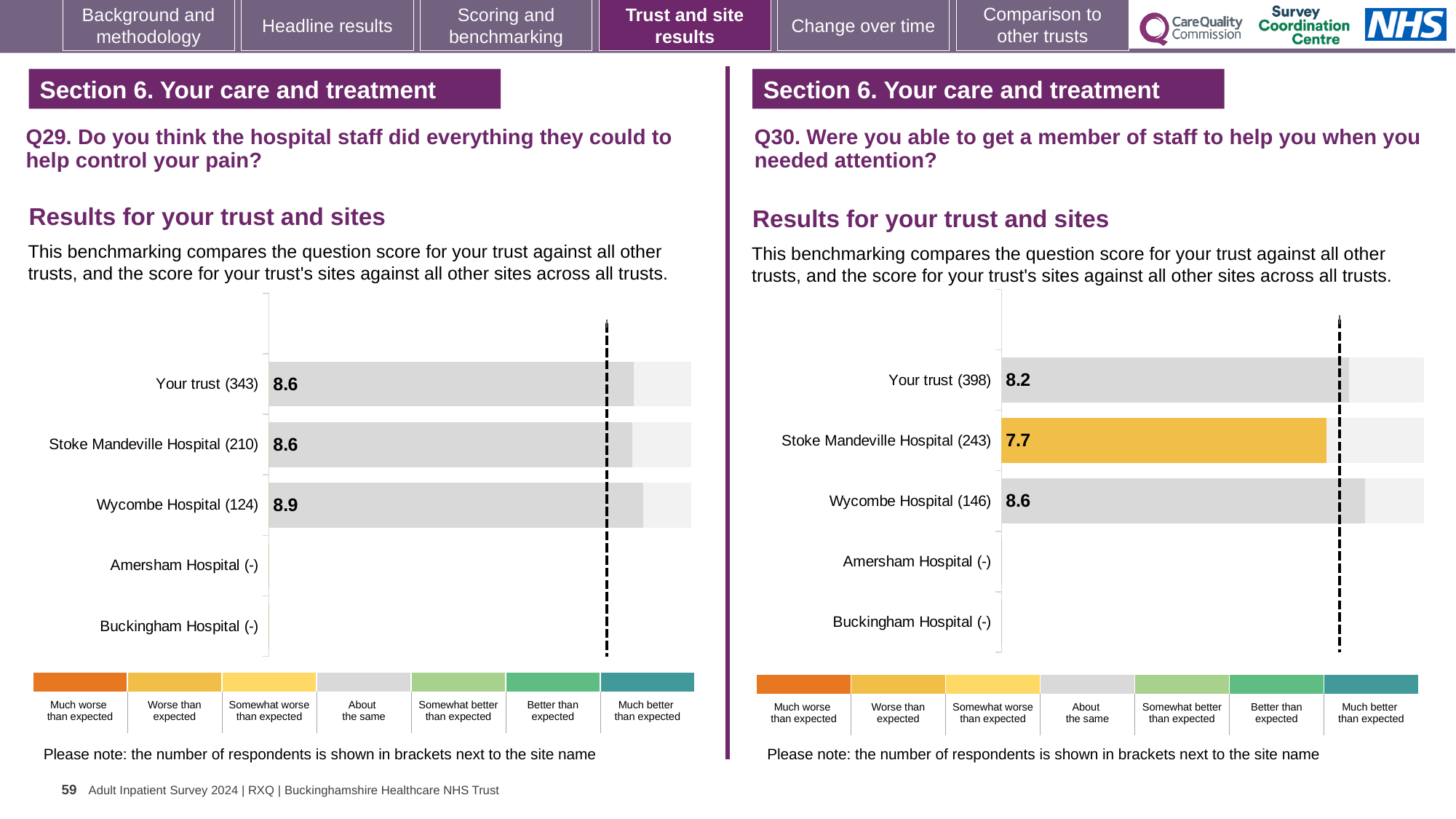
In the Q29 chart on the left, what is the difference between the scores for Wycombe Hospital and Your trust? 0.3 How many site rows (including Your trust) are listed in the Q29 chart on the left? 5 What type of chart is used in the Q29 chart on the left? Bar chart In the Q29 chart on the left, what is the score for Wycombe Hospital? 8.9 In the Q30 chart on the right, what is the difference between the scores for Wycombe Hospital and Stoke Mandeville Hospital? 0.9 In the Q30 chart on the right, which site has the lowest score? Stoke Mandeville Hospital In the Q30 chart on the right, what is the score for Stoke Mandeville Hospital? 7.7 In the Q30 chart on the right, which is larger: the score for Your trust or the score for Wycombe Hospital? Wycombe Hospital How many respondents are shown in brackets for Your trust in the Q30 chart on the right? 398 In the Q29 chart on the left, what is the score for Your trust? 8.6 In the Q30 chart on the right, what is the score for Your trust? 8.2 In the Q29 chart on the left, which site has the highest score? Wycombe Hospital